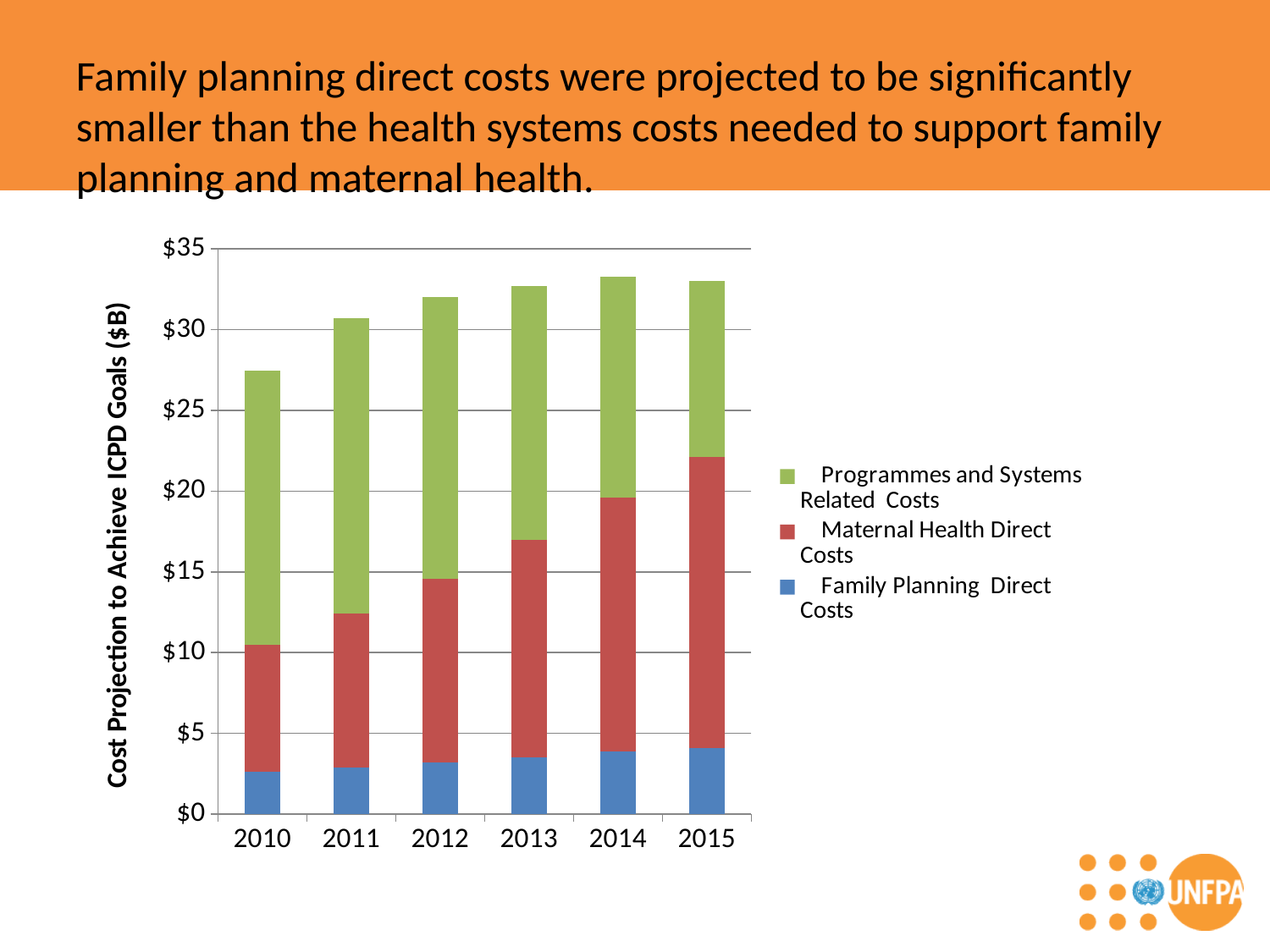
Is the total cost projection for 2010 greater or less than $25? greater Which year has the lowest total cost projection? 2010 What kind of chart is shown on the slide? Stacked bar chart Which colour represents Maternal Health Direct Costs in the chart? Red How many years are shown on the x axis of the chart? 6 Is the total cost projection for 2011 greater or less than $30? greater Does the Programmes and Systems Related Costs segment rise or fall from 2010 to 2015? fall How many series does the chart's legend list? 3 Does the Family Planning Direct Costs segment rise or fall from 2010 to 2015? rise Is the Family Planning Direct Costs value for 2010 greater or less than $5? less What is the title of the chart's vertical axis? Cost Projection to Achieve ICPD Goals ($B)